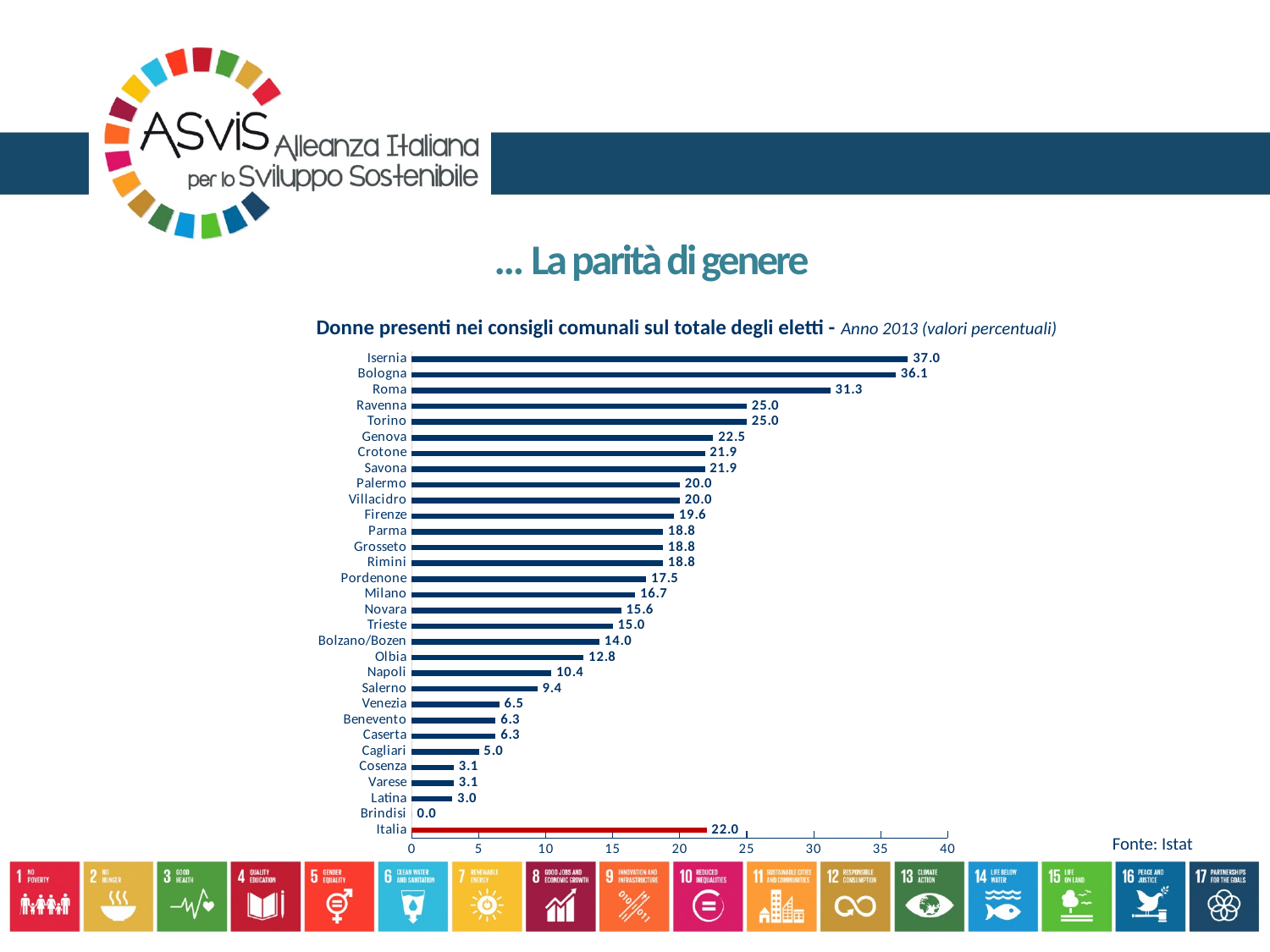
What is the value shown for Italia? 22.0 Which category has the highest value? Isernia Which category has the lowest value? Brindisi Which bar is drawn in red rather than dark blue? Italia What is the difference between the values for Italia and Venezia? 15.5 What is the value for Milano? 16.7 What is the difference between the values for Isernia and Roma? 5.7 How many bars are plotted in the chart? 31 What kind of chart is shown on the slide? Bar chart What is the value for Bologna? 36.1 Which has a larger value, Napoli or Salerno? Napoli Is the value for Genova greater or less than 20? greater